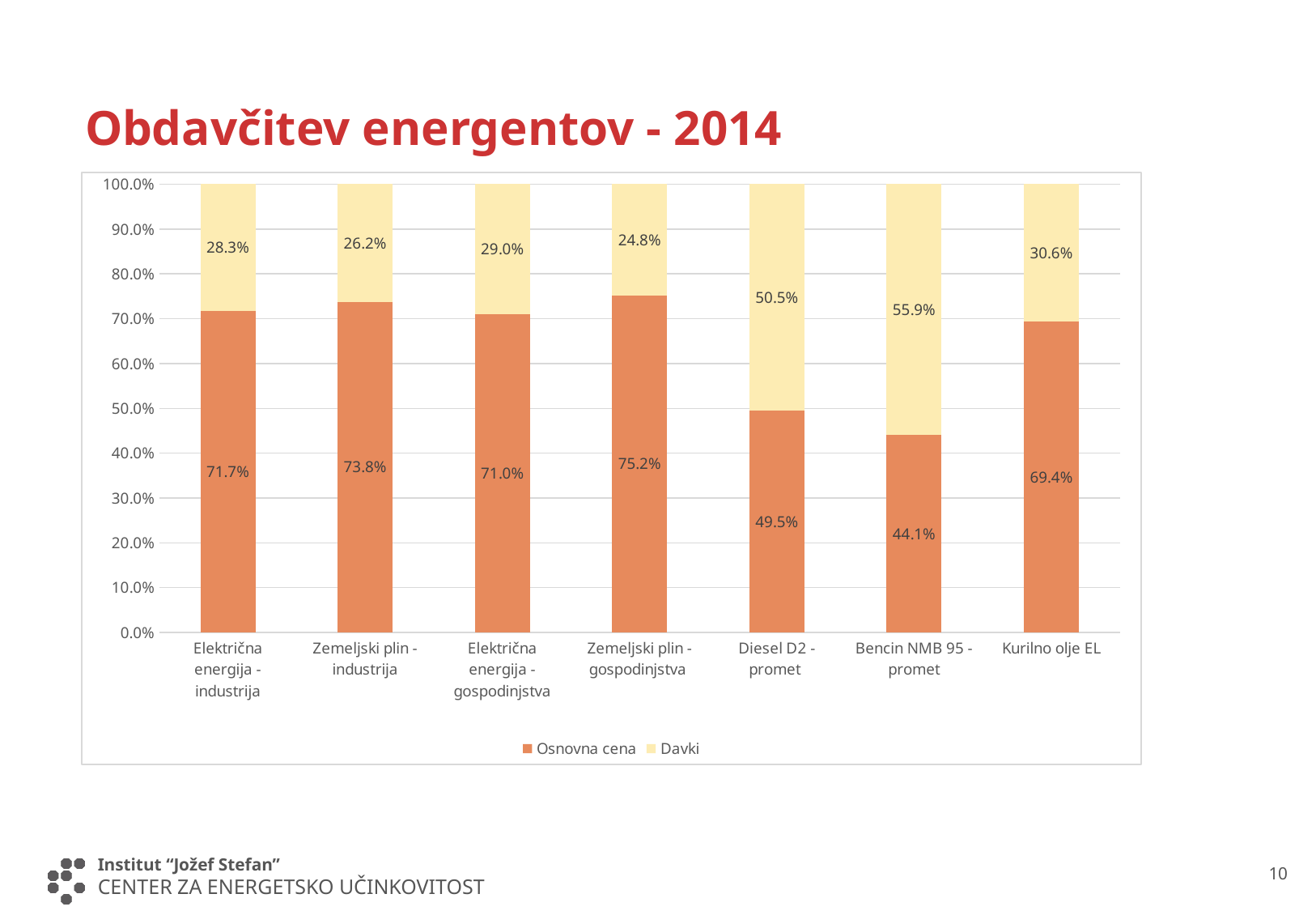
What is the title of the slide? Obdavčitev energentov - 2014 What is the difference between the Davki values for Bencin NMB 95 - promet and Diesel D2 - promet? 5.4% How many series does the legend list? 2 What is the Osnovna cena value for Diesel D2 - promet? 49.5% Which category has the highest Davki share? Bencin NMB 95 - promet What is the Davki value for Zemeljski plin - gospodinjstva? 24.8% Which is larger: the Osnovna cena value for Električna energija - industrija or for Kurilno olje EL? Električna energija - industrija What is the Davki value for Kurilno olje EL? 30.6% What kind of chart is shown on the slide? Stacked bar chart Which category has the lowest Osnovna cena share? Bencin NMB 95 - promet Which category has the highest Osnovna cena share? Zemeljski plin - gospodinjstva How many categories are shown on the x axis? 7